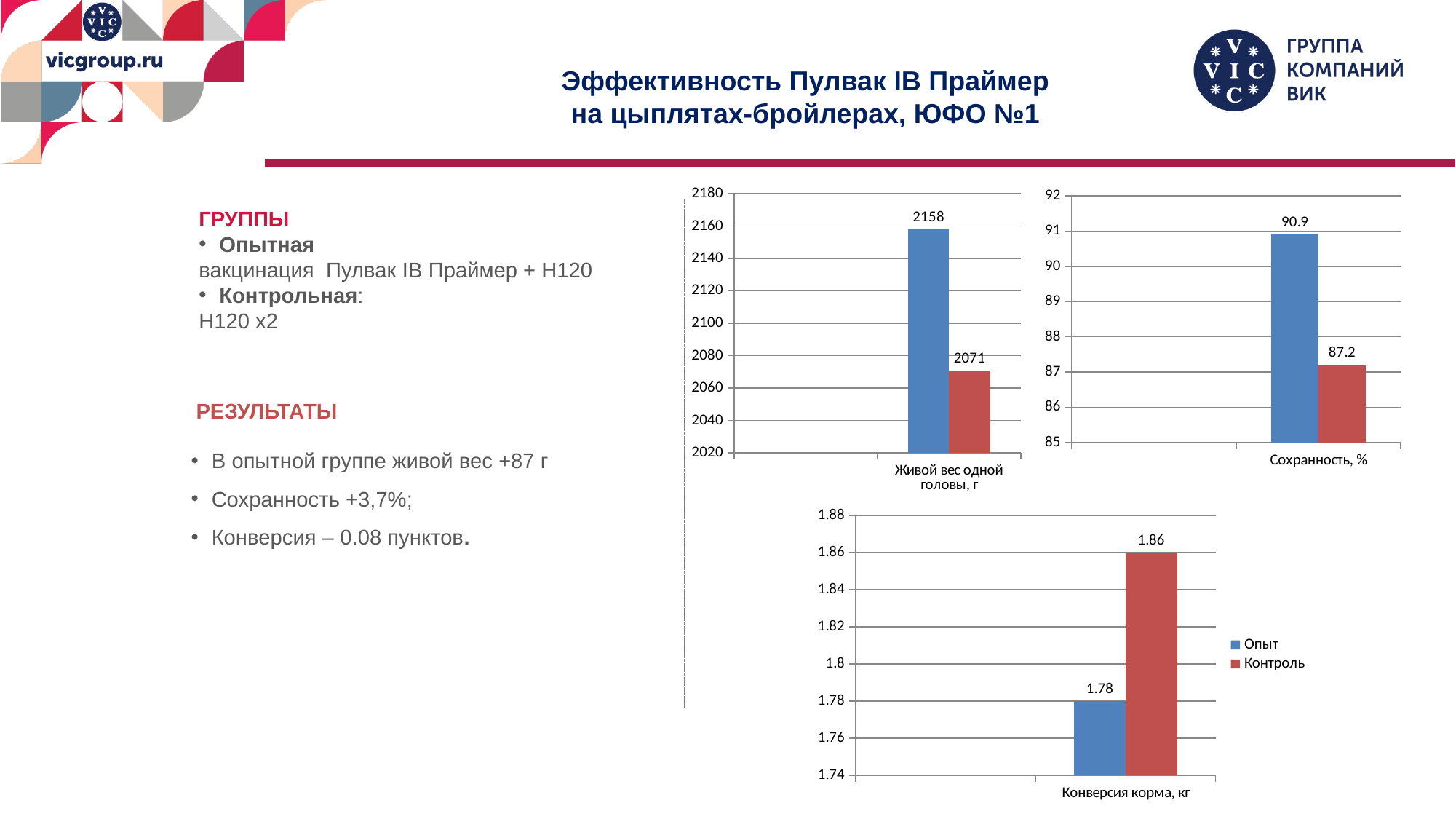
In the chart labelled 'Конверсия корма, кг', what is the value for Контроль? 1.86 In the chart labelled 'Конверсия корма, кг', which series has the higher value? Контроль In the chart labelled 'Сохранность, %', what value is shown on the blue bar? 90.9 In the chart labelled 'Конверсия корма, кг', what is the value for Опыт? 1.78 In the chart labelled 'Живой вес одной головы, г', what value is shown on the blue bar? 2158 What type of chart is the chart labelled 'Сохранность, %'? bar chart In the chart labelled 'Сохранность, %', what value is shown on the red bar? 87.2 In the chart labelled 'Живой вес одной головы, г', what value is shown on the red bar? 2071 In the chart labelled 'Конверсия корма, кг', what is the difference between Контроль and Опыт? 0.08 How many series does the legend of the chart labelled 'Конверсия корма, кг' list? 2 In the chart labelled 'Живой вес одной головы, г', what is the difference between the two bars? 87 In the chart labelled 'Сохранность, %', which bar is higher, the blue one or the red one? the blue one